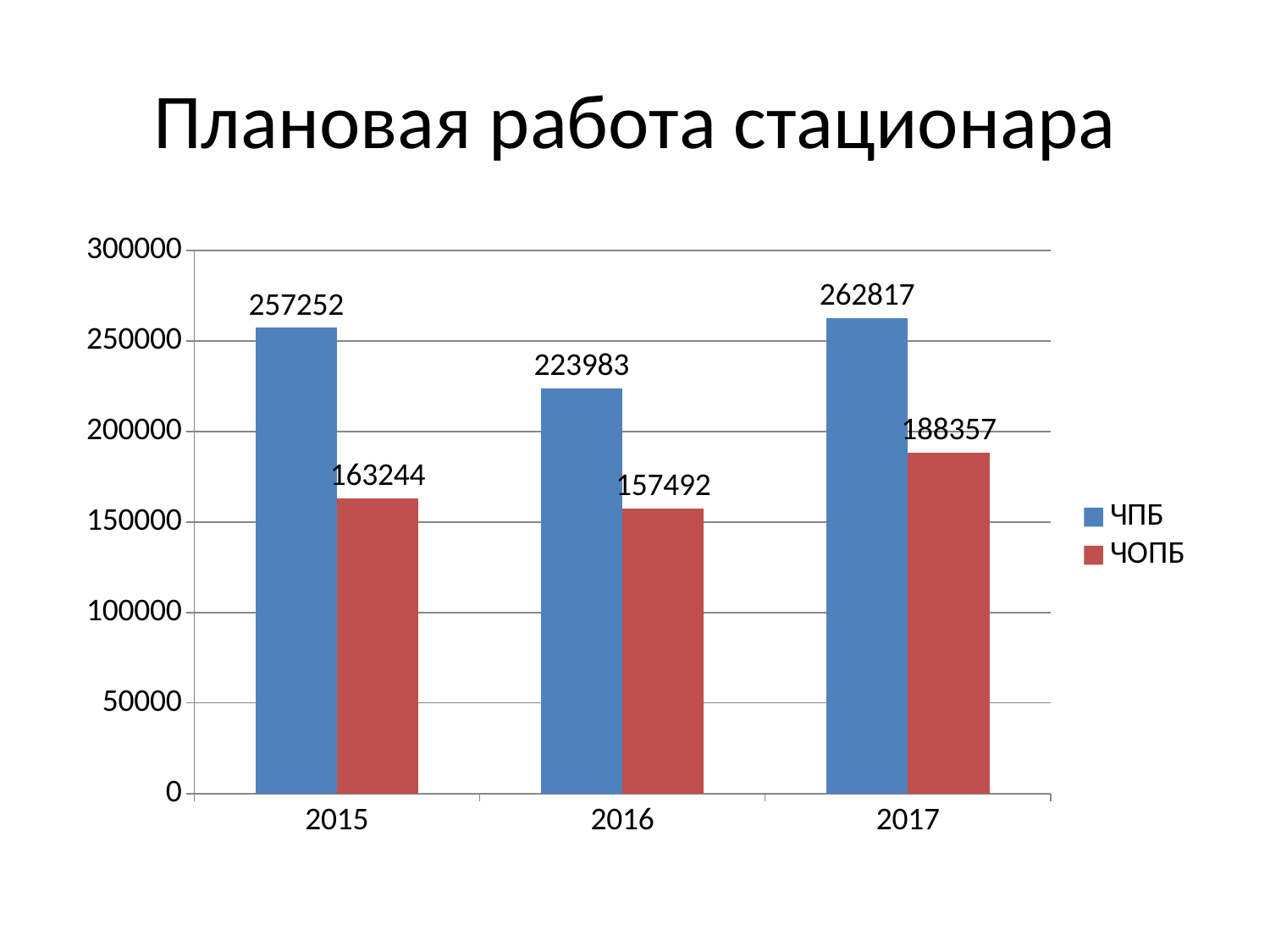
What is the value for ЧПБ in 2015? 257252 What is the value for ЧОПБ in 2016? 157492 What is the difference between the ЧПБ and ЧОПБ values in 2017? 74460 What is the difference between the ЧПБ values in 2017 and 2016? 38834 Is the value for ЧОПБ in 2017 greater or less than 200000? less What is the value for ЧОПБ in 2017? 188357 In which year is the ЧПБ value highest? 2017 How many series does the legend list? 2 How many years are shown on the x axis? 3 What kind of chart is shown on the slide? bar chart In which year is the ЧОПБ value lowest? 2016 Which is larger in 2015: ЧПБ or ЧОПБ? ЧПБ